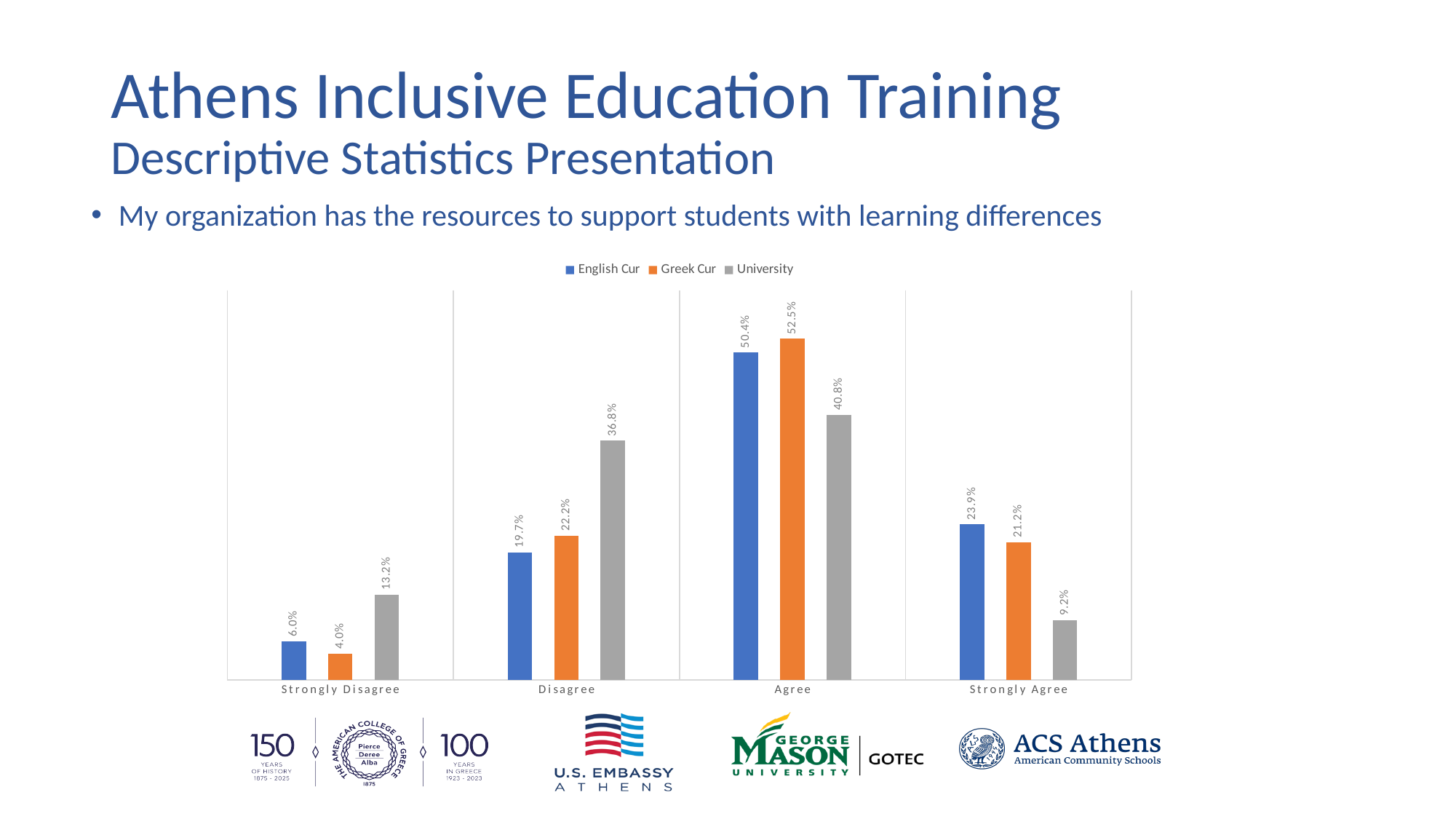
Which category has the highest value for the Greek Cur series? Agree What is the value for English Cur in the Agree category? 50.4% What kind of chart is shown on the slide? Bar chart Which category has the lowest value for the University series? Strongly Agree What is the value for University in the Strongly Agree category? 9.2% What is the value for University in the Disagree category? 36.8% How many series does the legend list? 3 In the Disagree category, which is larger: the University value or the English Cur value? University What is the difference between the Greek Cur and English Cur values in the Agree category? 2.1% How many categories are shown on the x axis? 4 Which colour represents the University series in the chart? Grey What is the value for Greek Cur in the Strongly Disagree category? 4.0%